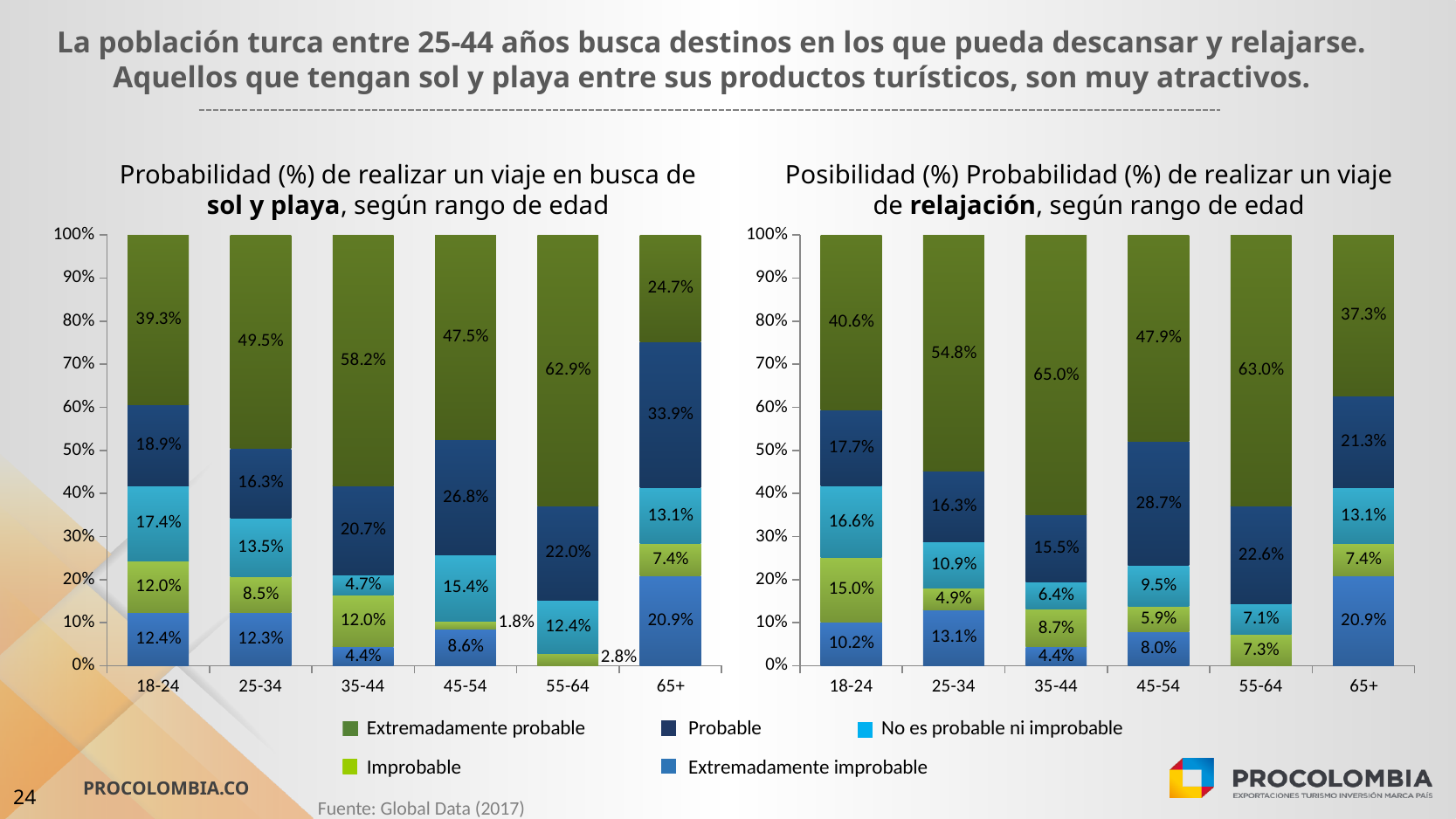
In the right chart (relajación), what is the value for 'Improbable' in the 18-24 age group? 15.0% How many age groups are shown on the x axis of the right chart (relajación)? 6 What is the source cited at the bottom of the slide? Global Data (2017) In the right chart (relajación), what is the value for 'Probable' in the 45-54 age group? 28.7% In the left chart (sol y playa), which age group has the highest 'Extremadamente probable' value? 55-64 In the left chart (sol y playa), which is larger: 'Probable' for 65+ or 'Probable' for 45-54? 65+ In the right chart (relajación), which age group has the lowest 'Extremadamente probable' value? 65+ In the left chart (sol y playa), what is the value for 'Extremadamente improbable' in the 65+ age group? 20.9% In the right chart (relajación), what is the difference between the 'Extremadamente probable' values for 35-44 and 18-24? 24.4% What type of chart is the left chart (sol y playa)? Stacked bar chart In the left chart (sol y playa), what is the value for 'Extremadamente probable' in the 35-44 age group? 58.2% How many series does the legend list? 5